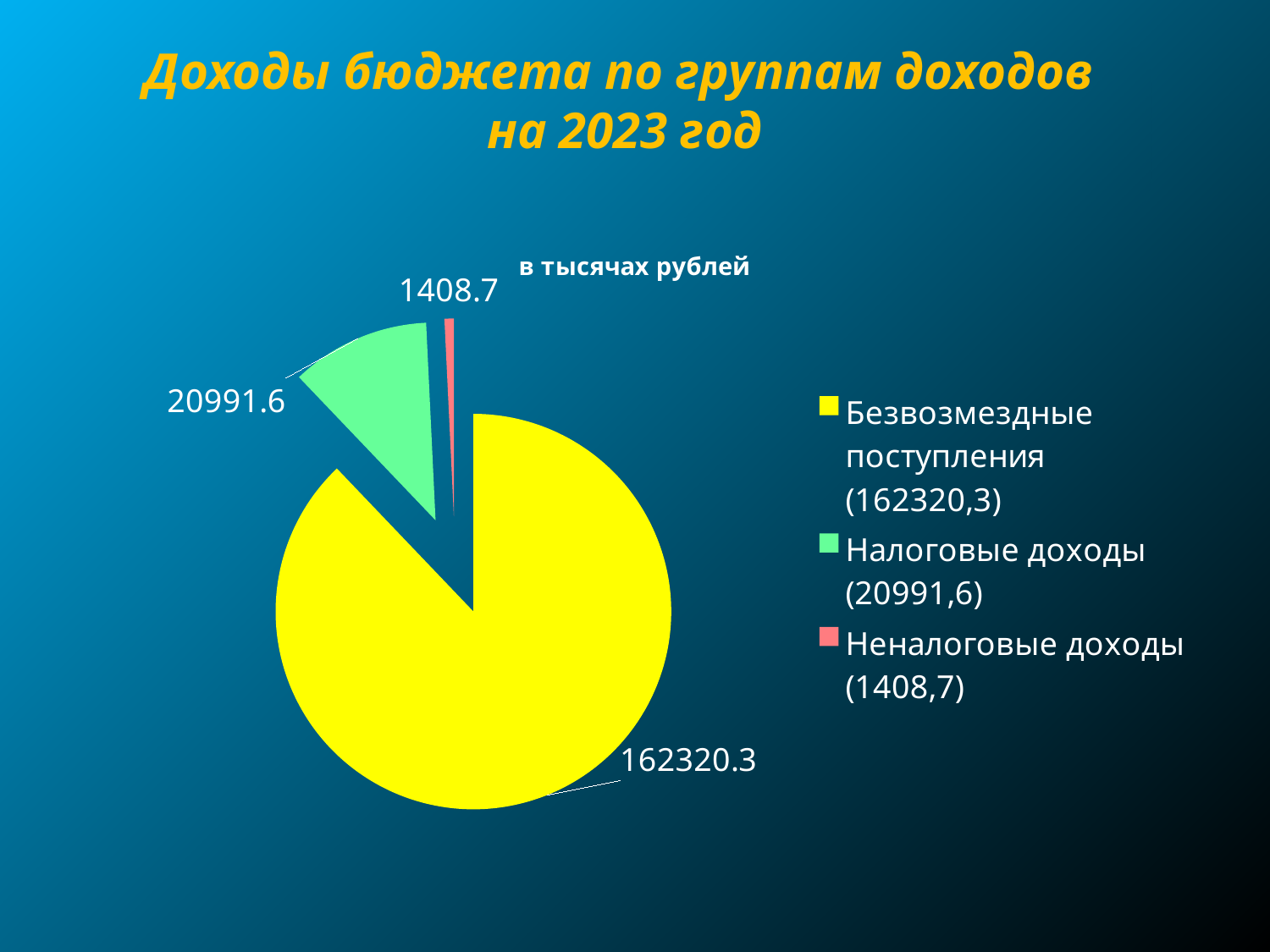
Which category has the largest slice of the pie? Безвозмездные поступления What is the value for Налоговые доходы? 20991.6 How many categories does the pie chart show? 3 What unit does the chart title say the values are in? в тысячах рублей What type of chart is shown on the slide? pie chart Which is larger, Налоговые доходы or Неналоговые доходы? Налоговые доходы What is the difference between the values for Безвозмездные поступления and Налоговые доходы? 141328.7 Which category has the smallest slice of the pie? Неналоговые доходы What is the total of all three slices of the pie? 184720.6 What is the value for Неналоговые доходы? 1408.7 What is the difference between the values for Налоговые доходы and Неналоговые доходы? 19582.9 What is the value for Безвозмездные поступления? 162320.3